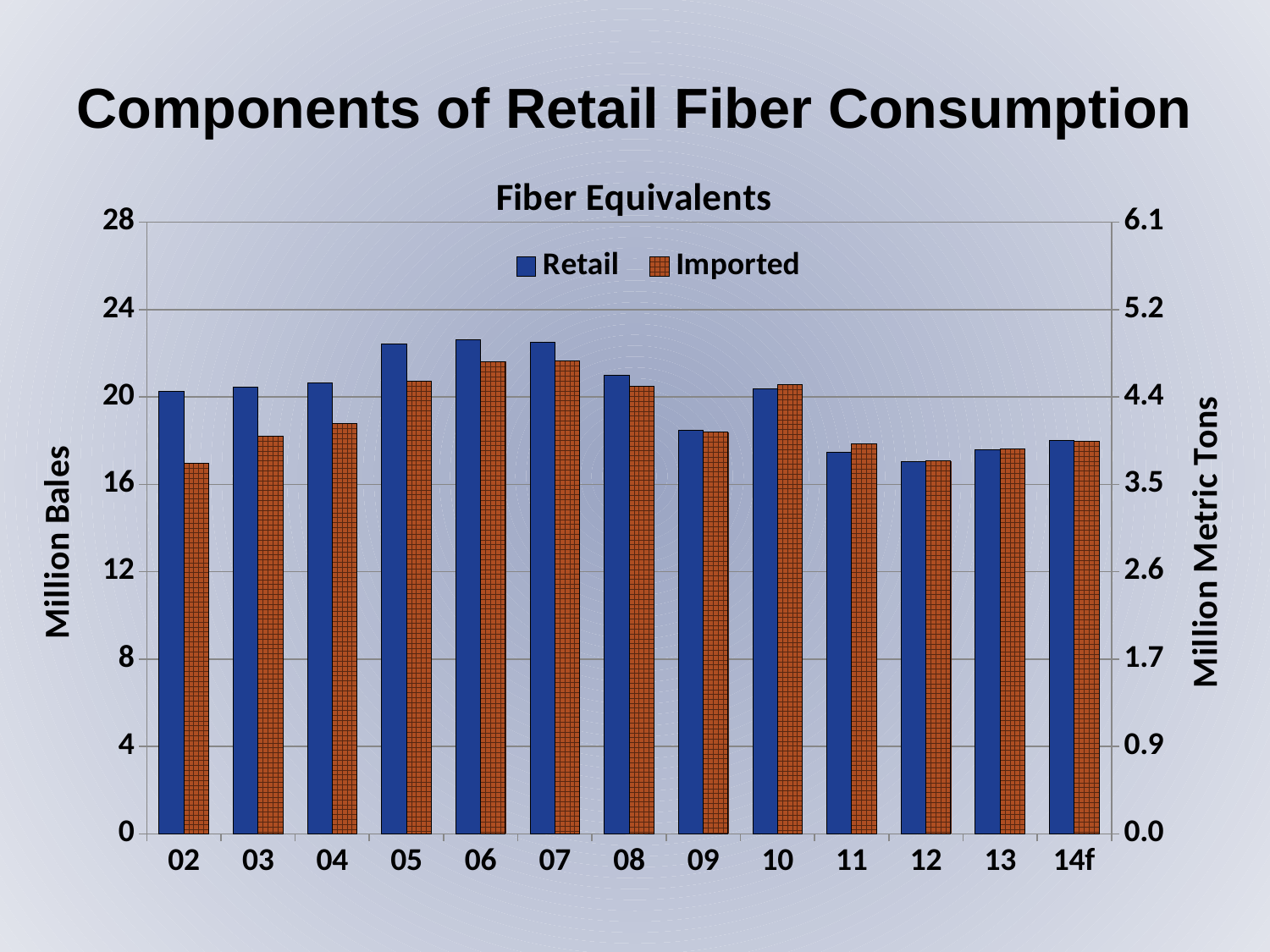
Do the Retail values rise or fall from 07 to 09? fall In 04, which is larger, Retail or Imported? Retail Is the Retail value for 09 greater or less than 20 million bales? less What kind of chart is shown on the slide? bar chart What is the title of the left vertical axis? Million Bales How many years are shown on the x axis? 13 Is the Imported value for 02 greater or less than 20 million bales? less In 02, which is larger, Retail or Imported? Retail Is the Retail value for 12 greater or less than 16 million bales? greater How many series does the legend list? 2